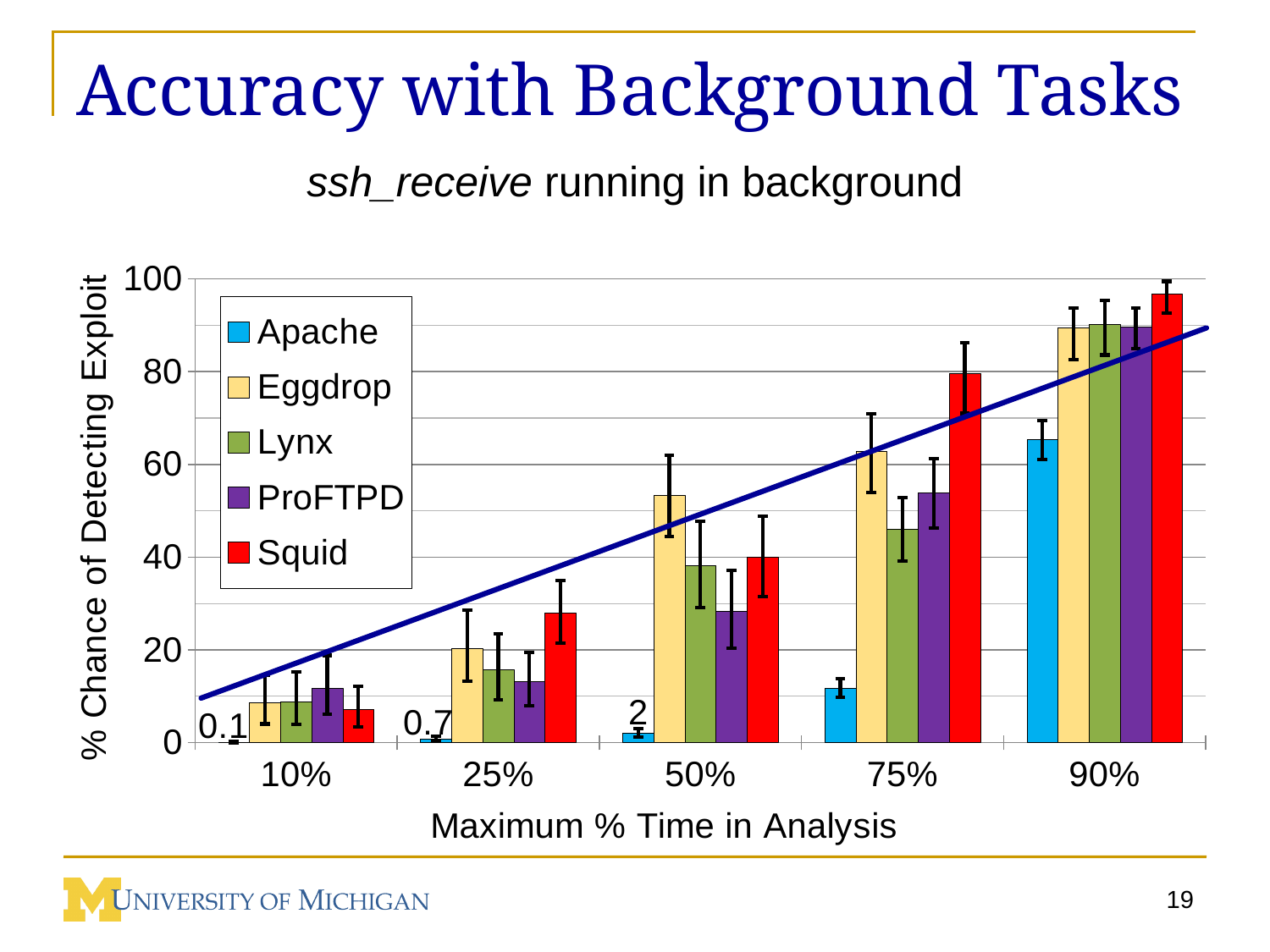
What is the value for Apache at 25% Maximum % Time in Analysis? 0.7 What is the value for Apache at 10% Maximum % Time in Analysis? 0.1 At 50%, which is larger, Eggdrop or Lynx? Eggdrop Which series has the highest value at 75%? Squid What is the difference between the Apache values at 50% and 10%? 1.9 Is the value for Eggdrop at 50% greater or less than 40? greater How many series does the legend list? 5 Is the value for Apache at 75% greater or less than 20? less What is the value for Apache at 50% Maximum % Time in Analysis? 2 Is the value for Squid at 90% greater or less than 80? greater Do the Squid values rise or fall as Maximum % Time in Analysis increases? rise Which series has the lowest value at 90%? Apache